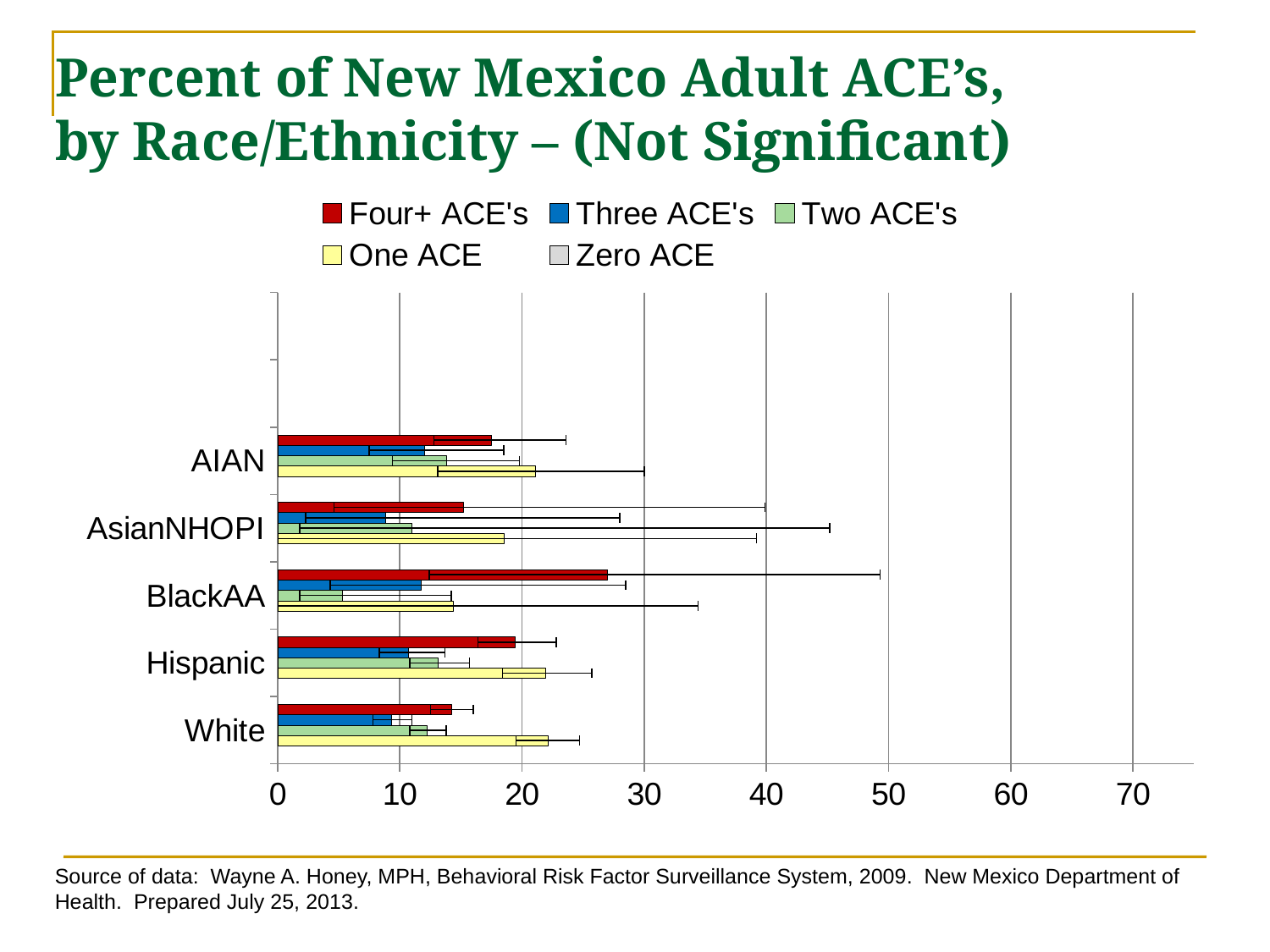
Is the Four+ ACE's value for AIAN greater or less than 20? less Which is larger, the Four+ ACE's value for BlackAA or for White? BlackAA What colour represents Four+ ACE's in the legend? Red Is the Four+ ACE's value for BlackAA greater or less than 20? greater Which race/ethnicity group has the highest value for Four+ ACE's? BlackAA What kind of chart is shown on the slide? Bar chart Is the Two ACE's value for BlackAA greater or less than 10? less How many race/ethnicity categories are labelled on the chart? 5 What is the title of the chart on the slide? Percent of New Mexico Adult ACE's, by Race/Ethnicity – (Not Significant) Which is larger, the One ACE value for Hispanic or for BlackAA? Hispanic How many series does the legend list? 5